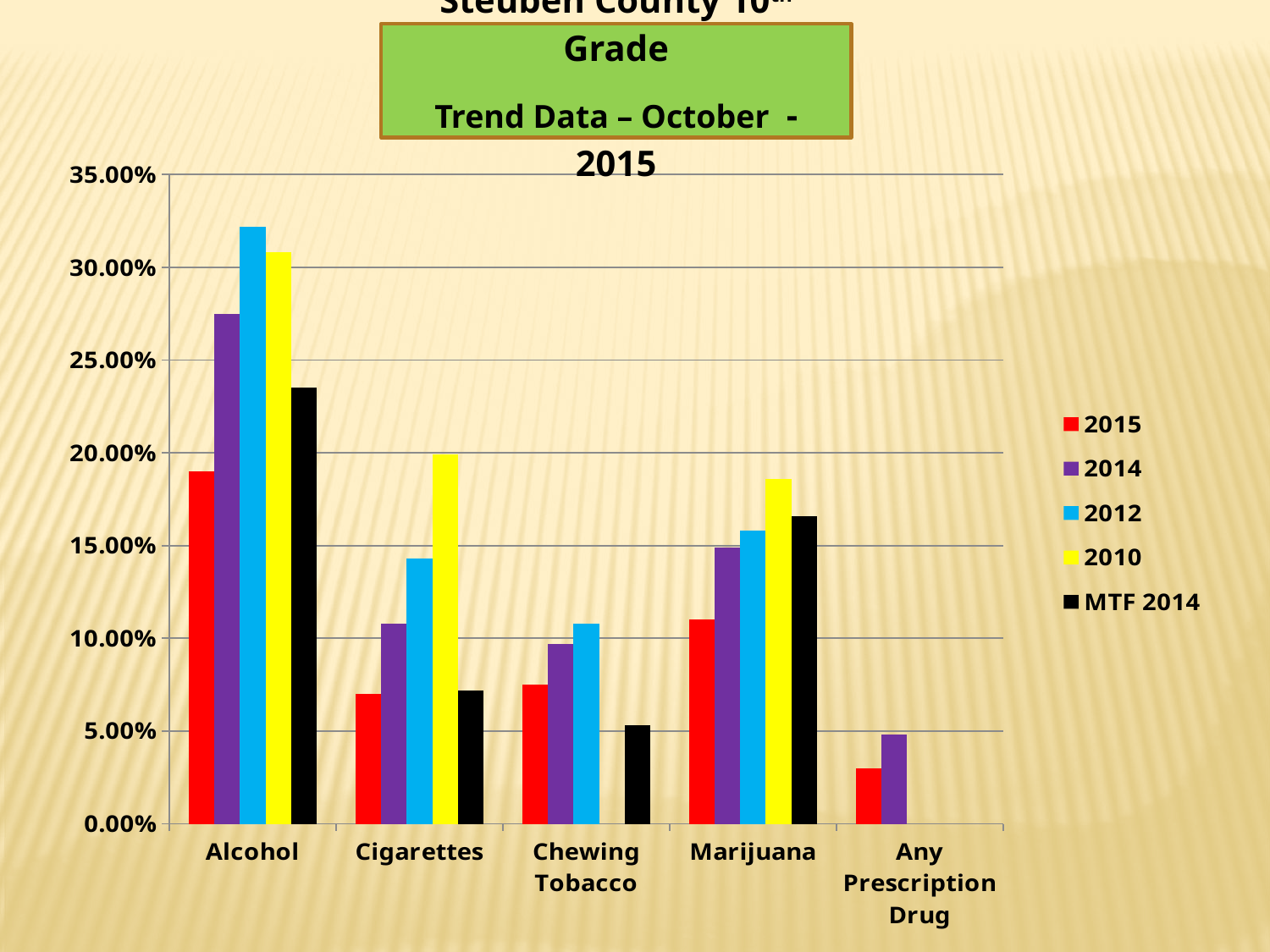
What kind of chart is shown on the slide? bar chart How many categories are shown on the x axis? 5 Is the 2010 value for Cigarettes greater or less than 15.00%? greater Is the MTF 2014 value for Chewing Tobacco greater or less than 10.00%? less Is the 2015 value for Alcohol greater or less than 20.00%? less How many series does the legend list? 5 For Marijuana, which series has the larger value, 2015 or 2014? 2014 Which category has the lowest value for the 2015 series? Any Prescription Drug What colour represents the 2010 series in the legend? yellow Which category has the highest value for the 2012 series? Alcohol For Cigarettes, which series has the larger value, 2010 or 2012? 2010